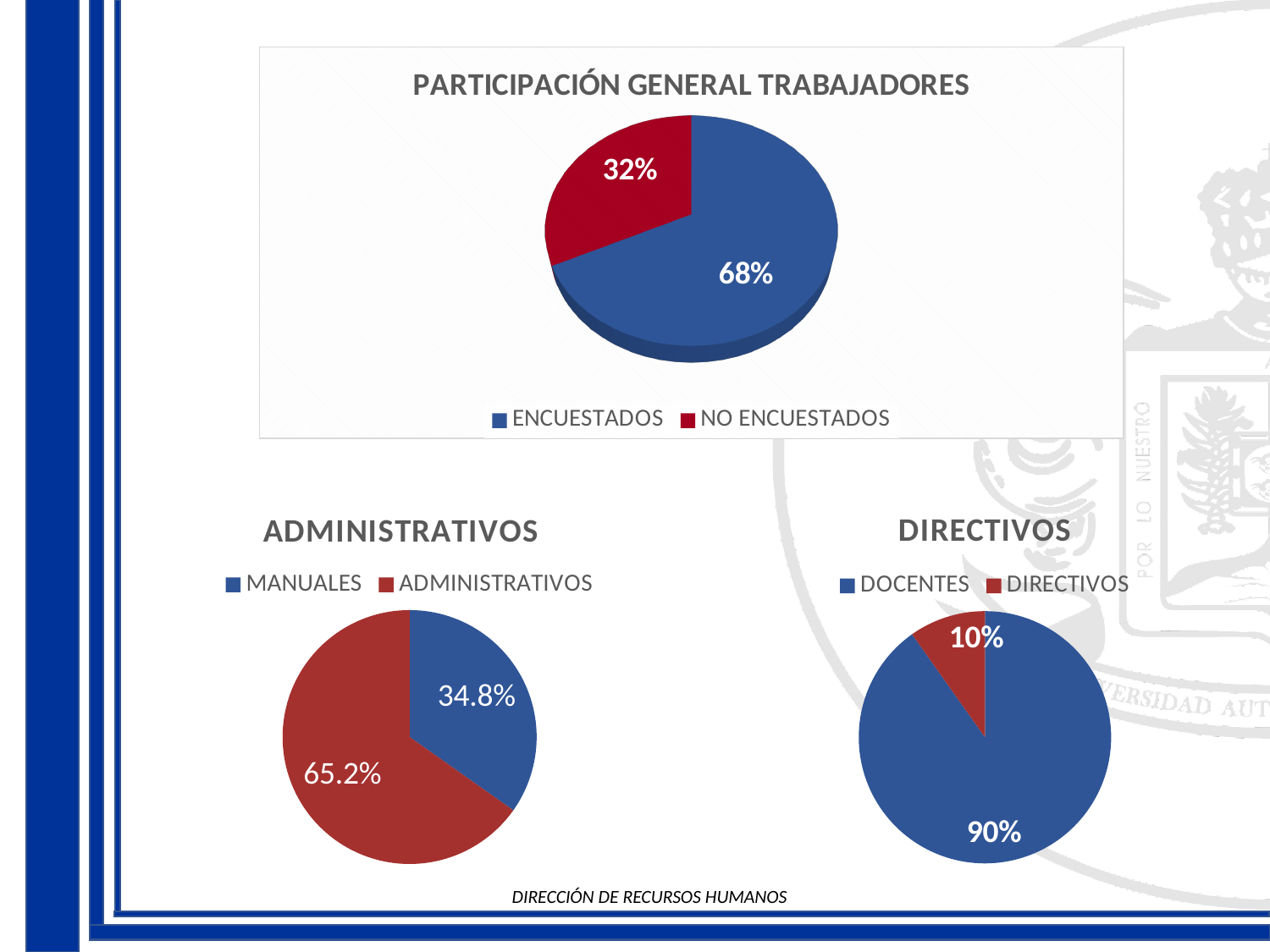
How many entries does the legend of the 'ADMINISTRATIVOS' chart list? 2 In the 'DIRECTIVOS' chart, what percentage is shown for DOCENTES? 90% In the 'ADMINISTRATIVOS' chart, what percentage is shown for ADMINISTRATIVOS? 65.2% In the 'PARTICIPACIÓN GENERAL TRABAJADORES' chart, which slice is larger, ENCUESTADOS or NO ENCUESTADOS? ENCUESTADOS In the 'PARTICIPACIÓN GENERAL TRABAJADORES' chart, what percentage is shown for NO ENCUESTADOS? 32% In the 'PARTICIPACIÓN GENERAL TRABAJADORES' chart, what is the difference in percentage points between ENCUESTADOS and NO ENCUESTADOS? 36 In the 'ADMINISTRATIVOS' chart, which category has the largest slice? ADMINISTRATIVOS In the 'DIRECTIVOS' chart, which category has the smallest slice? DIRECTIVOS What kind of chart is the 'PARTICIPACIÓN GENERAL TRABAJADORES' chart? Pie chart In the 'PARTICIPACIÓN GENERAL TRABAJADORES' chart, what percentage is shown for ENCUESTADOS? 68% In the 'DIRECTIVOS' chart, what percentage is shown for DIRECTIVOS? 10% In the 'ADMINISTRATIVOS' chart, what percentage is shown for MANUALES? 34.8%